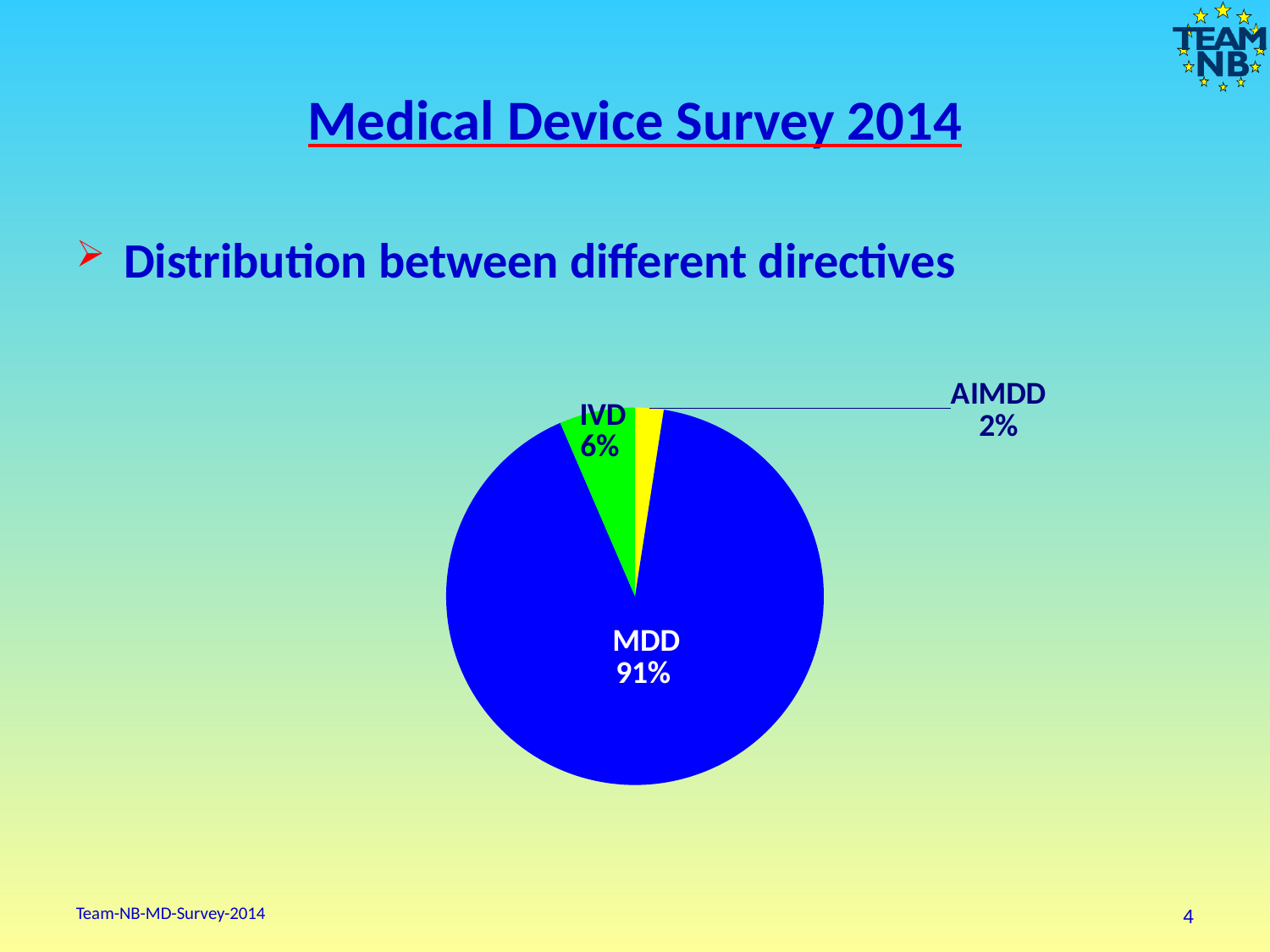
What share of the pie does AIMDD account for? 2% What is the difference in percentage points between the MDD and IVD slices? 85 What colour is the IVD slice of the pie? green Which directive has the smallest slice of the pie? AIMDD Which slice is larger, IVD or AIMDD? IVD What share of the pie does MDD account for? 91% What share of the pie does IVD account for? 6% How many slices does the pie chart have? 3 Which directive has the largest slice of the pie? MDD What colour is the MDD slice of the pie? blue What kind of chart is shown on the slide? pie chart What is the difference in percentage points between the IVD and AIMDD slices? 4